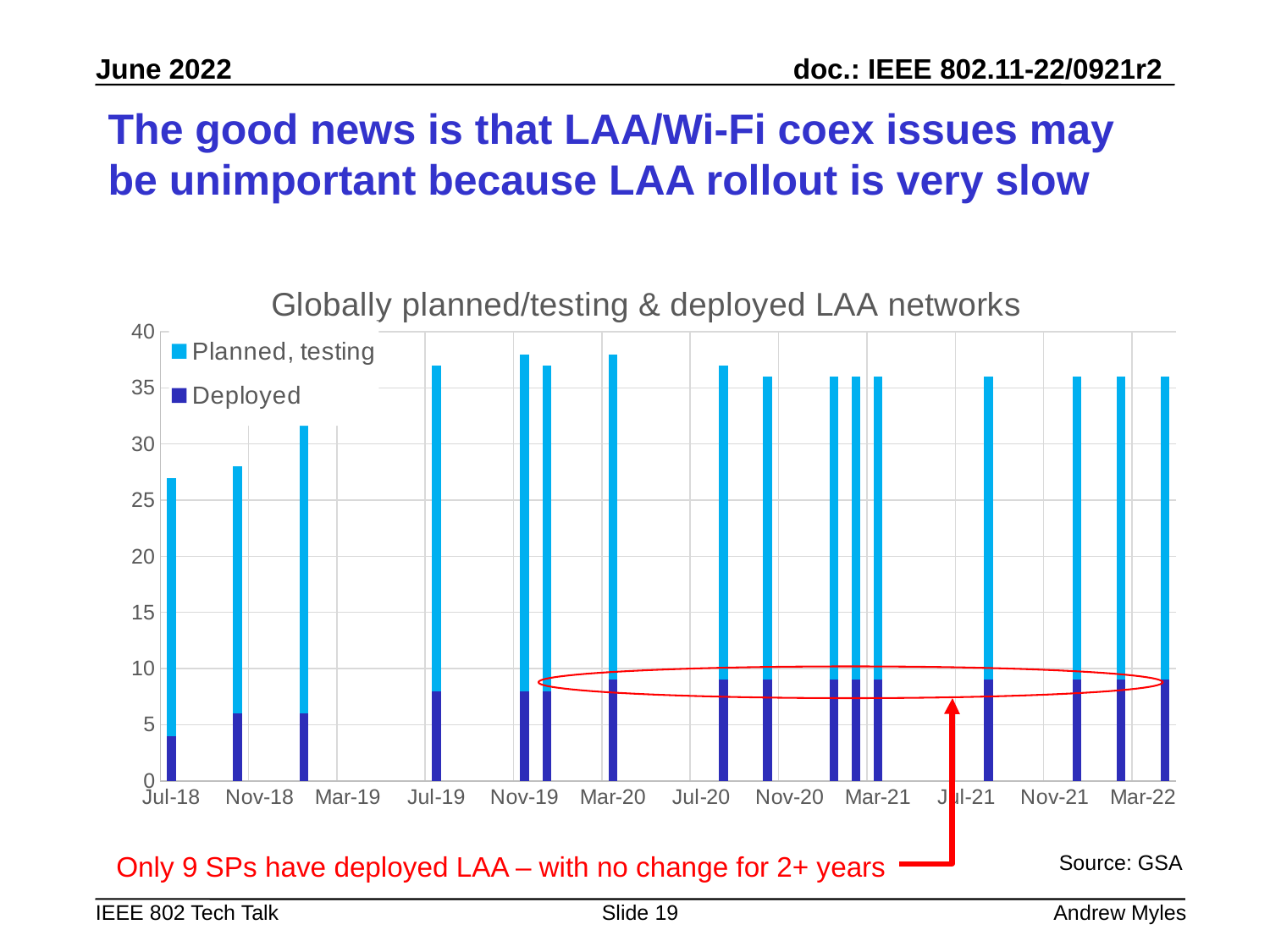
Which two series are listed in the chart legend? Planned, testing; Deployed Is the Deployed value at Mar-22 greater or less than 5? greater What kind of chart is shown on the slide? Stacked bar chart Is the total height of the bar at Nov-18 greater or less than 30? less Is the Deployed value at Jul-18 greater or less than 5? less Which date has the lowest total bar on the chart? Jul-18 How many series does the chart legend list? 2 Do the total bar heights generally rise or fall from Jul-18 to Mar-22? rise What is the title of the chart? Globally planned/testing & deployed LAA networks Which bar has the lowest total, the one at Jul-18 or the one at Jul-19? Jul-18